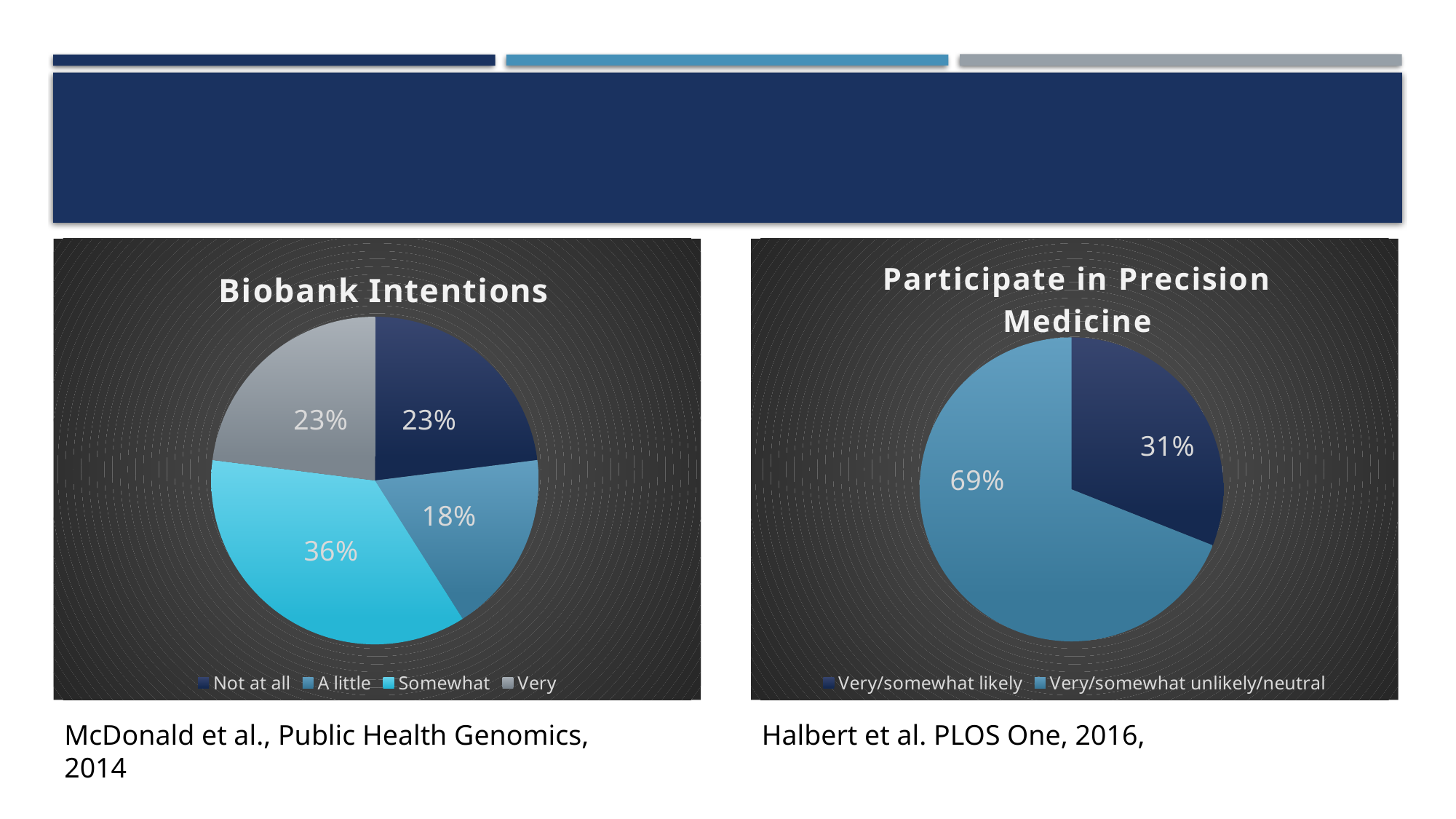
What kind of chart is the Biobank Intentions chart? Pie chart In the Biobank Intentions chart, which category has the smallest slice? A little In the Participate in Precision Medicine chart, what share is Very/somewhat unlikely/neutral? 69% In the Biobank Intentions chart, how many categories does the legend list? 4 In the Participate in Precision Medicine chart, how many slices does the pie have? 2 In the Biobank Intentions chart, what share of respondents answered Not at all? 23% In the Participate in Precision Medicine chart, which slice is larger, Very/somewhat likely or Very/somewhat unlikely/neutral? Very/somewhat unlikely/neutral In the Biobank Intentions chart, what share of respondents answered Somewhat? 36% In the Participate in Precision Medicine chart, what share is Very/somewhat likely? 31% In the Biobank Intentions chart, what share of respondents answered A little? 18% In the Biobank Intentions chart, which category has the largest slice? Somewhat In the Biobank Intentions chart, what is the difference in percentage points between Somewhat and A little? 18